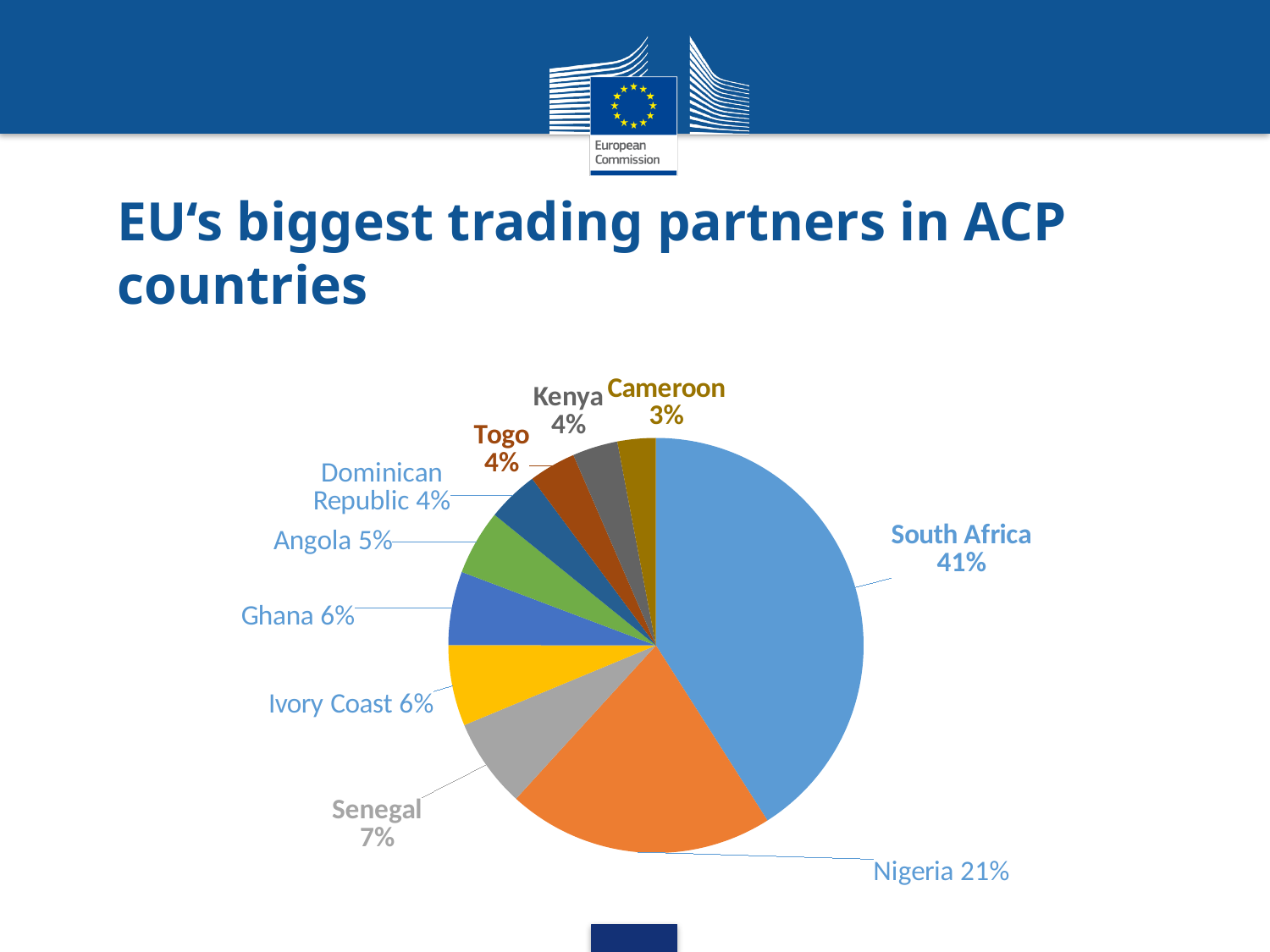
What is the difference between Senegal's share and Angola's share? 2% What type of chart is shown on the slide? Pie chart Which country has the smallest slice of the pie? Cameroon What is the value for the Dominican Republic? 4% What is the difference between South Africa's share and Nigeria's share? 20% What percentage is shown for Senegal? 7% What is the value shown for Nigeria? 21% How many countries are shown as slices in the pie chart? 10 What share of the pie does South Africa hold? 41% What is the title of the slide containing the chart? EU's biggest trading partners in ACP countries Which is larger, the share for Nigeria or the share for Senegal? Nigeria Which country has the largest slice of the pie? South Africa